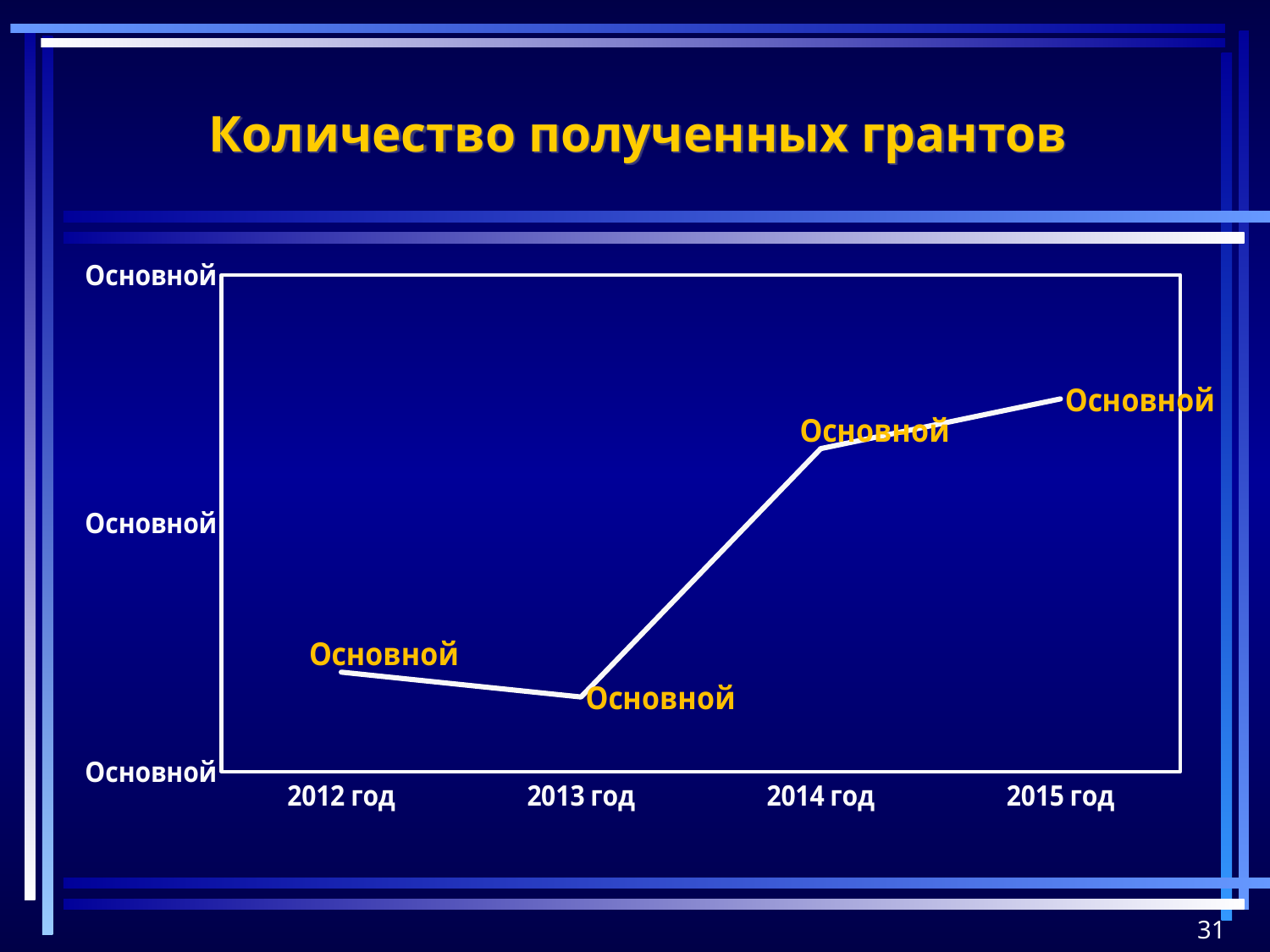
Does the value rise or fall from 2012 год to 2013 год? fall Which year has the lowest value on the chart? 2013 год What kind of chart is shown on the slide? line chart What is the title of the chart? Количество полученных грантов Overall, does the line rise or fall from 2012 год to 2015 год? rise How many data points are plotted on the line? 4 Which year has the highest value on the chart? 2015 год What is the first category label on the x axis? 2012 год Which is larger, the value for 2014 год or the value for 2012 год? 2014 год Does the value rise or fall from 2013 год to 2014 год? rise Which is larger, the value for 2012 год or the value for 2013 год? 2012 год